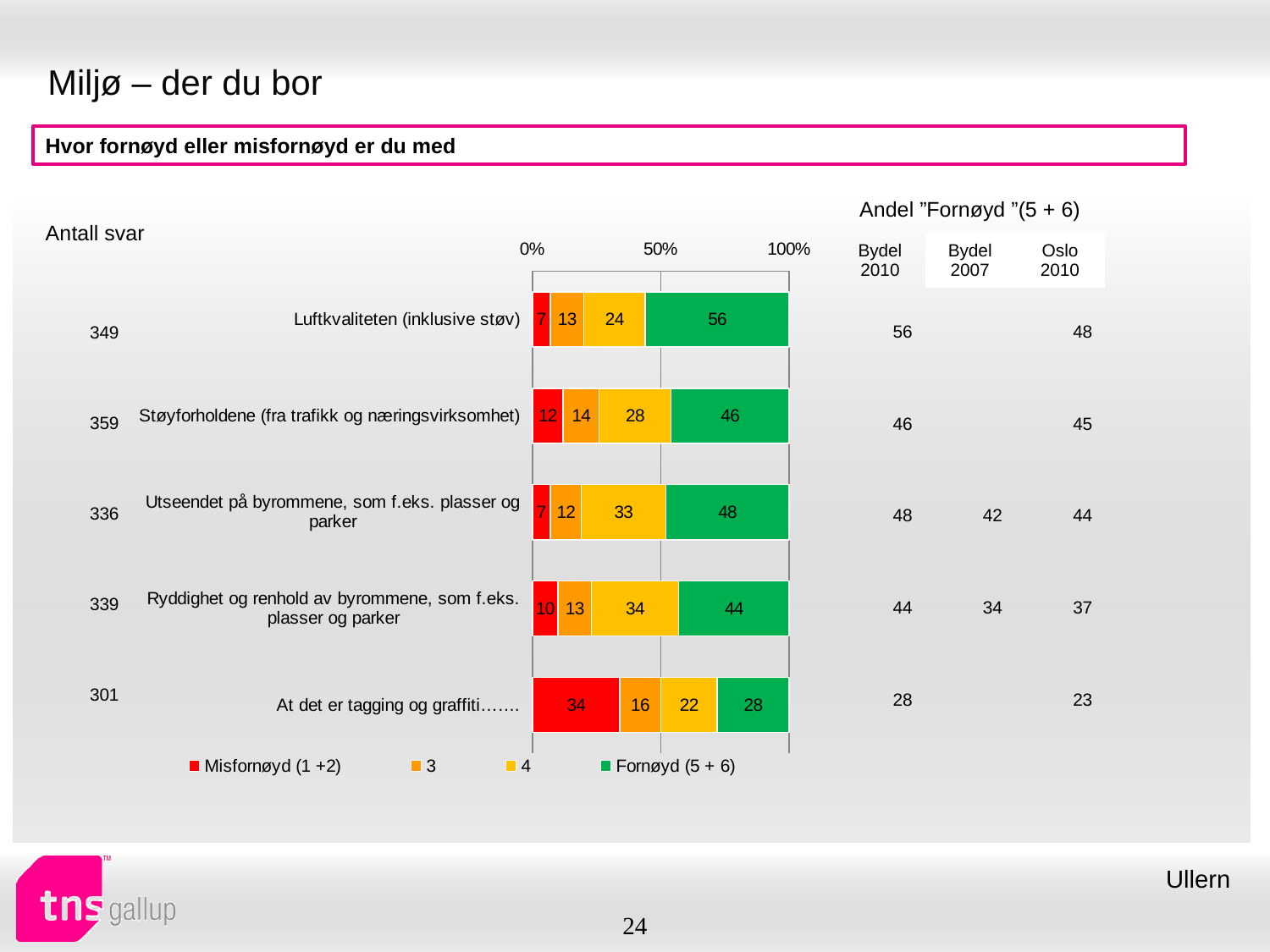
What is the difference between the 'Fornøyd (5 + 6)' values for 'Luftkvaliteten (inklusive støv)' and 'Støyforholdene (fra trafikk og næringsvirksomhet)'? 10 How many series does the legend list? 4 What is the value of series '3' for 'Støyforholdene (fra trafikk og næringsvirksomhet)'? 14 Which category has the highest 'Fornøyd (5 + 6)' value? Luftkvaliteten (inklusive støv) What is the 'Misfornøyd (1 +2)' value for 'At det er tagging og graffiti…….'? 34 What kind of chart is shown on the slide? Stacked bar chart Which is larger: the 'Misfornøyd (1 +2)' value for 'Støyforholdene (fra trafikk og næringsvirksomhet)' or for 'Ryddighet og renhold av byrommene, som f.eks. plasser og parker'? Støyforholdene (fra trafikk og næringsvirksomhet) How many categories are shown in the chart? 5 What is the total of the stacked bar for 'At det er tagging og graffiti…….'? 100 What is the 'Fornøyd (5 + 6)' value for 'Luftkvaliteten (inklusive støv)'? 56 What is the value of series '4' for 'Ryddighet og renhold av byrommene, som f.eks. plasser og parker'? 34 Which category has the lowest 'Fornøyd (5 + 6)' value? At det er tagging og graffiti…….